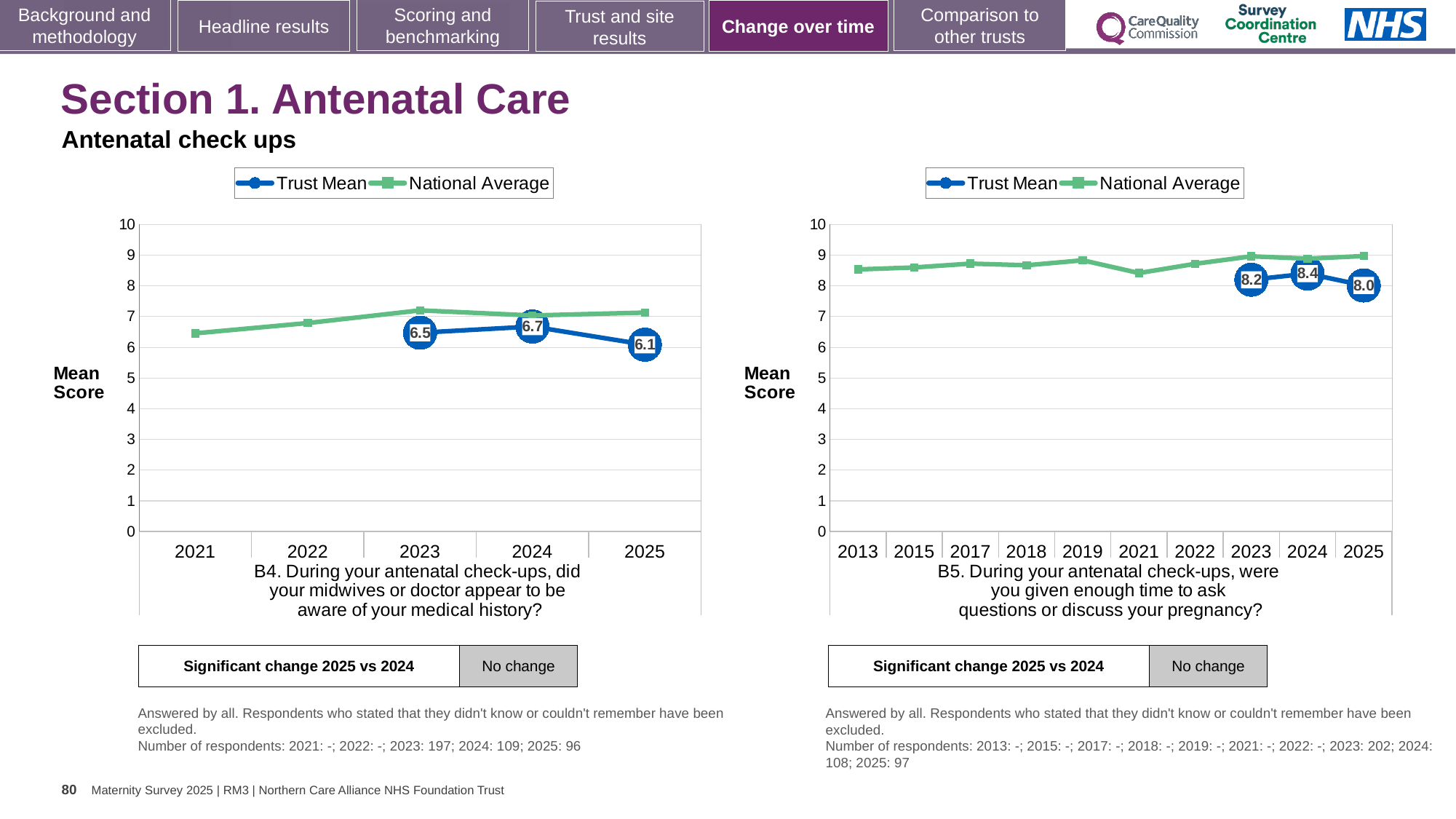
In the right chart (B5), what is the Trust Mean score for 2024? 8.4 In the right chart (B5), which is larger, the Trust Mean for 2023 or for 2024? 2024 In the left chart (B4), which year has the highest labelled Trust Mean score? 2024 How many series does the legend of the left chart (B4) list? 2 In the right chart (B5), what is the Trust Mean score for 2025? 8.0 In the left chart (B4), is the National Average value for 2021 greater or less than 7? less In the left chart (B4), what is the Trust Mean score for 2023? 6.5 How many years are shown on the x axis of the right chart (B5)? 10 In the left chart (B4), what is the Trust Mean score for 2025? 6.1 What kind of chart is the left chart (B4)? Line chart In the left chart (B4), what is the difference between the Trust Mean scores for 2024 and 2025? 0.6 In the right chart (B5), which year has the lowest labelled Trust Mean score? 2025